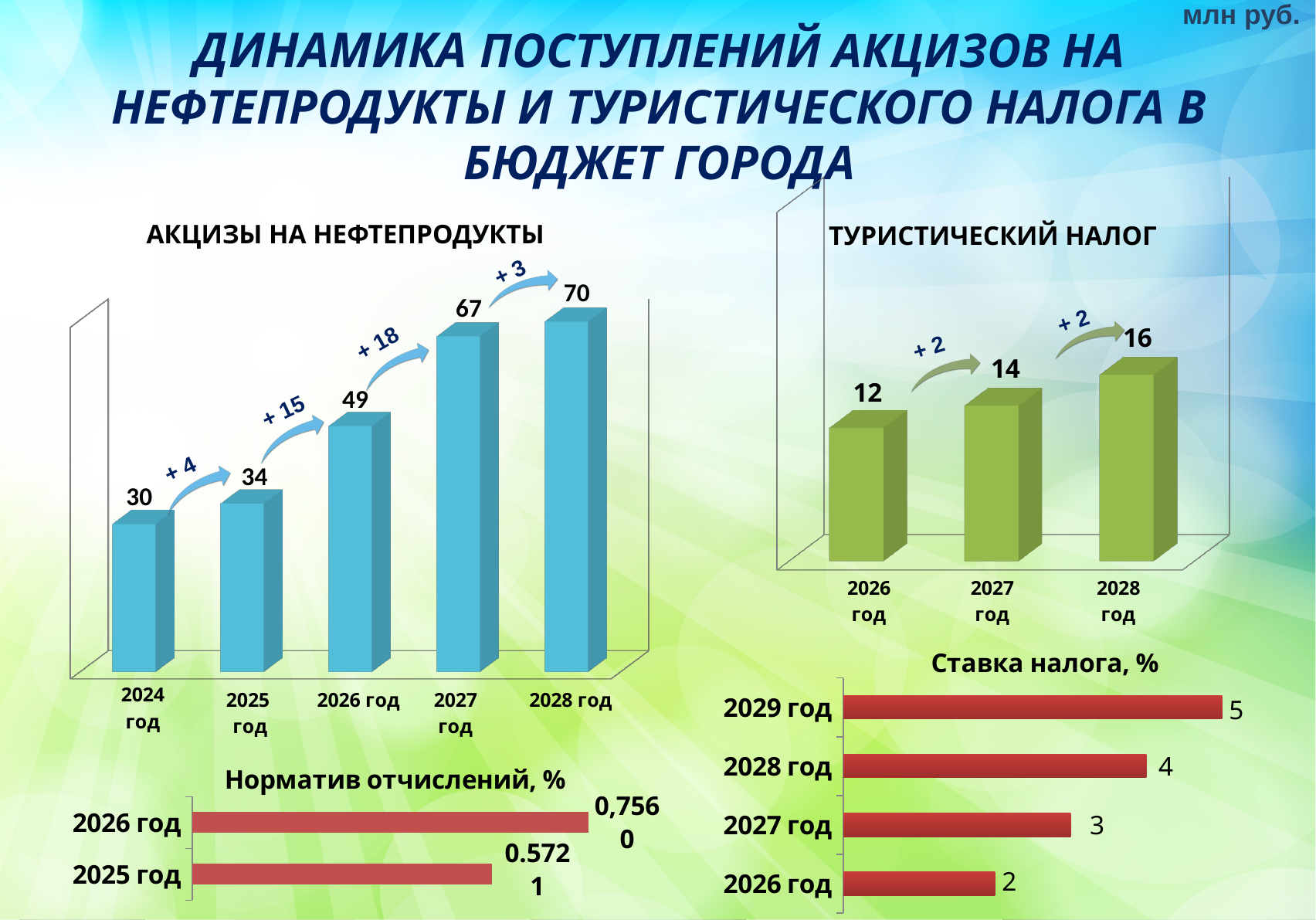
In the "Ставка налога, %" chart, what is the value for 2028 год? 4 In the "АКЦИЗЫ НА НЕФТЕПРОДУКТЫ" chart, do the values rise or fall from 2024 to 2028? rise In the "АКЦИЗЫ НА НЕФТЕПРОДУКТЫ" chart, which year has the lowest value? 2024 год In the "АКЦИЗЫ НА НЕФТЕПРОДУКТЫ" chart, what is the difference between the values for 2027 год and 2026 год? 18 What kind of chart is the "ТУРИСТИЧЕСКИЙ НАЛОГ" chart? bar chart In the "АКЦИЗЫ НА НЕФТЕПРОДУКТЫ" chart, which year has the highest value? 2028 год How many years are shown in the "АКЦИЗЫ НА НЕФТЕПРОДУКТЫ" chart? 5 In the "Норматив отчислений, %" chart, which year has the larger value, 2026 год or 2025 год? 2026 год In the "ТУРИСТИЧЕСКИЙ НАЛОГ" chart, what is the difference between the values for 2028 год and 2026 год? 4 In the "Ставка налога, %" chart, which year has the highest value? 2029 год In the "АКЦИЗЫ НА НЕФТЕПРОДУКТЫ" chart, what is the value for 2026 год? 49 In the "ТУРИСТИЧЕСКИЙ НАЛОГ" chart, what is the value for 2027 год? 14